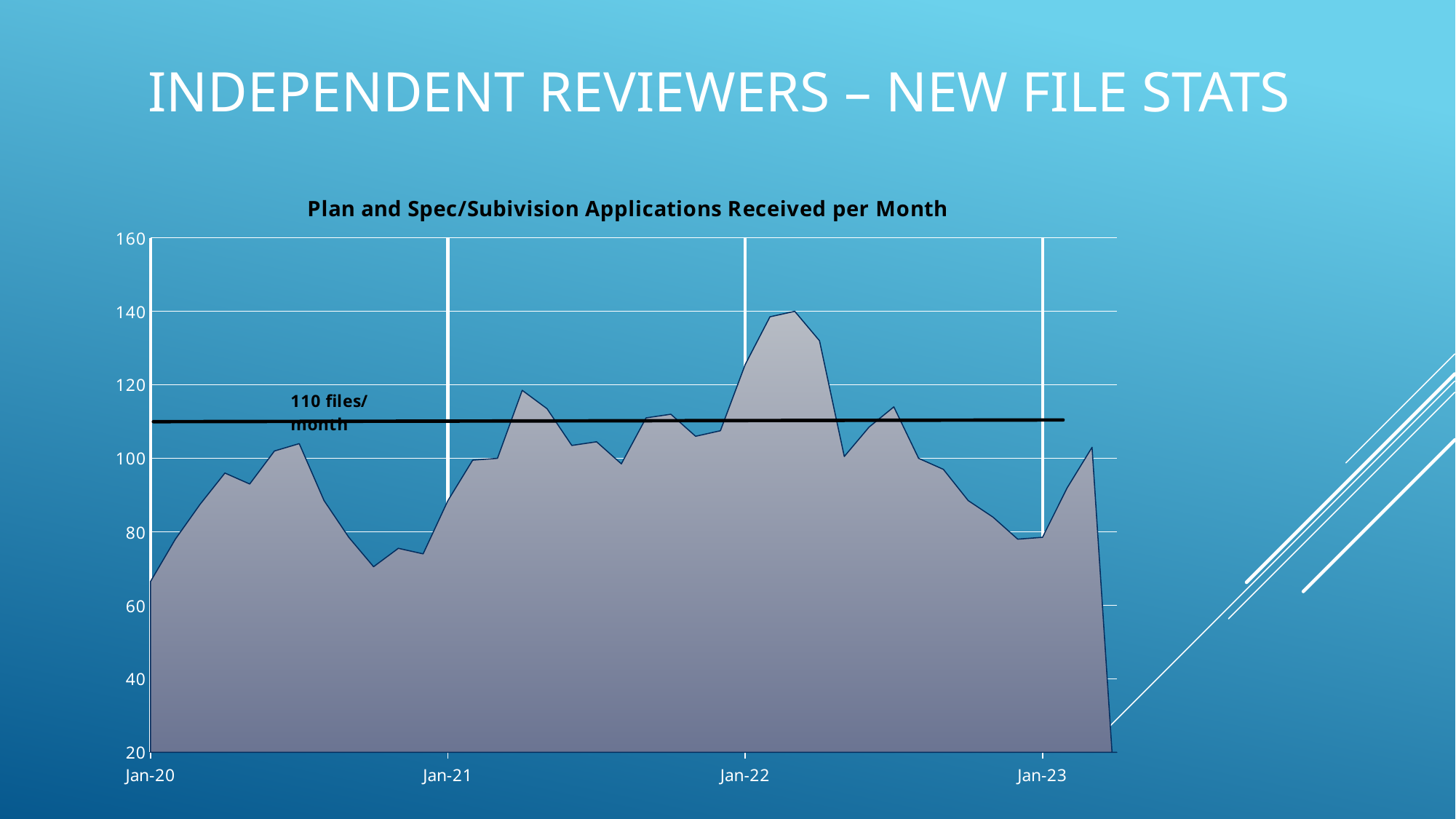
Is the value for Jan-21 greater or less than 80? greater Do the values generally rise or fall between the peak after Jan-22 and Jan-23? fall What is the title of the chart? Plan and Spec/Subivision Applications Received per Month Is the value for Jan-22 greater or less than 120? greater Is the value for Jan-23 greater or less than 100? less What is the highest value shown on the y axis? 160 What value does the horizontal black reference line on the chart mark? 110 files/month Between which two x-axis labels does the highest peak of the chart occur? Jan-22 and Jan-23 What kind of chart is shown on the slide? area chart